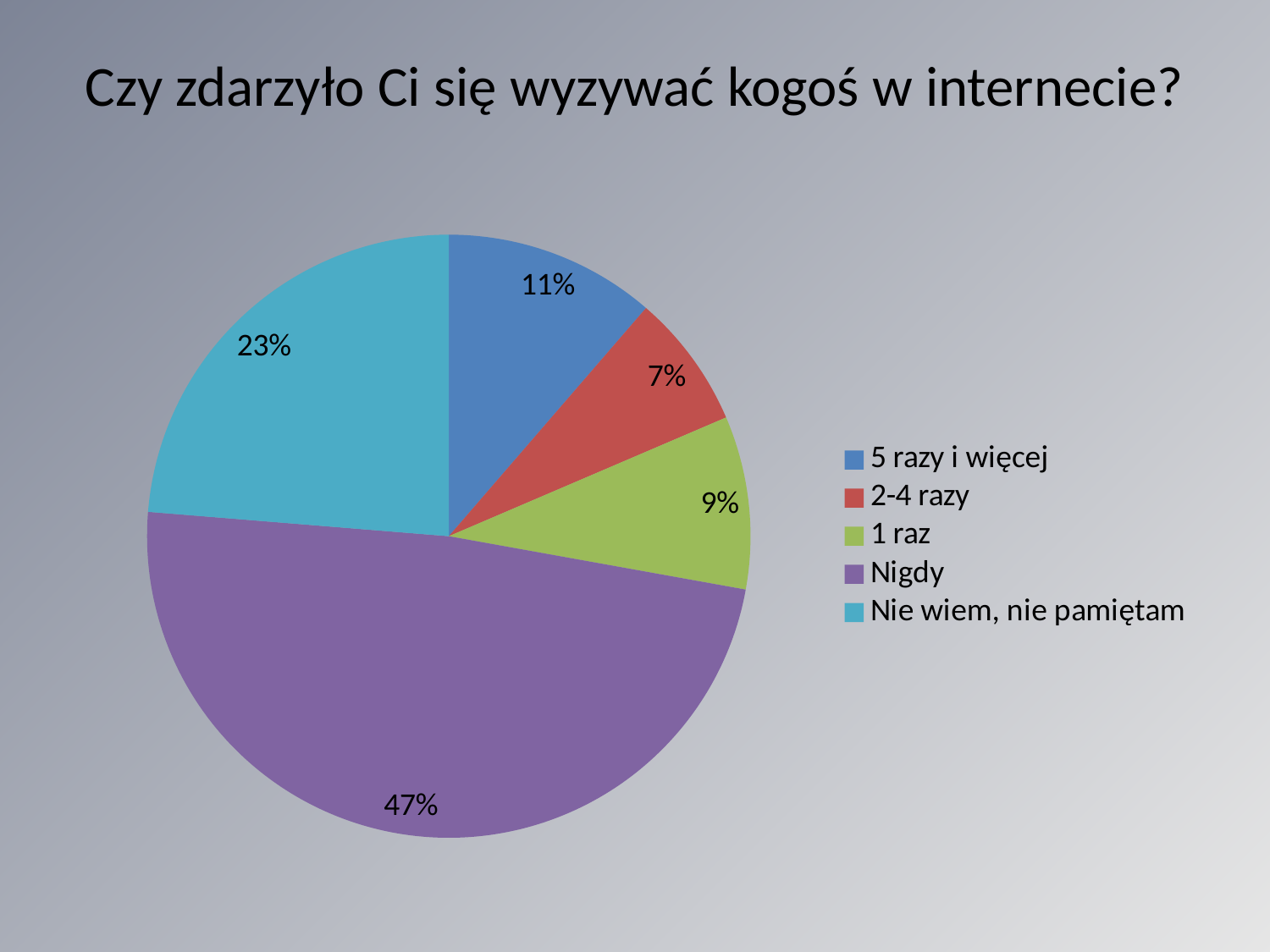
Which category has the largest share of the pie? Nigdy What percentage of respondents answered "5 razy i więcej"? 11% What is the title of the chart? Czy zdarzyło Ci się wyzywać kogoś w internecie? What type of chart is shown on the slide? pie chart How many categories does the legend list? 5 What percentage of respondents answered "Nigdy"? 47% Which category has the smallest share of the pie? 2-4 razy What percentage of respondents answered "Nie wiem, nie pamiętam"? 23% What is the difference in percentage points between "Nigdy" and "Nie wiem, nie pamiętam"? 24 Which is larger, the share for "5 razy i więcej" or the share for "1 raz"? 5 razy i więcej What percentage of respondents answered "2-4 razy"? 7% What percentage of respondents answered "1 raz"? 9%